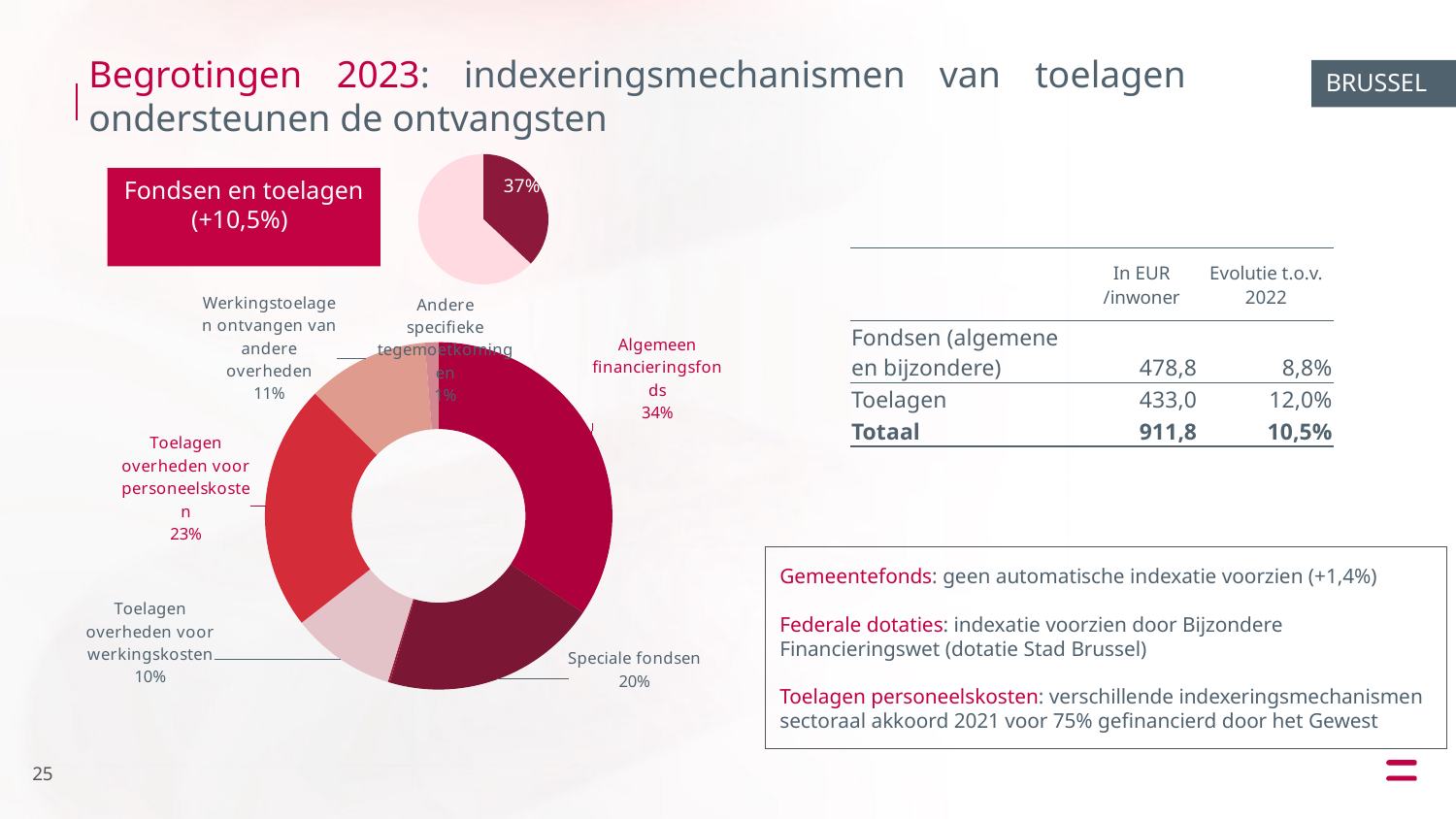
In the doughnut chart on the left, what share does Werkingstoelagen ontvangen van andere overheden have? 11% In the doughnut chart on the left, what is the difference in percentage points between Algemeen financieringsfonds and Speciale fondsen? 14 percentage points In the doughnut chart on the left, what share does Algemeen financieringsfonds have? 34% In the doughnut chart on the left, which is larger: Toelagen overheden voor personeelskosten or Speciale fondsen? Toelagen overheden voor personeelskosten In the small pie chart at the top next to the 'Fondsen en toelagen' box, what percentage is printed on the dark slice? 37% In the doughnut chart on the left, what share does Toelagen overheden voor personeelskosten have? 23% What kind of chart is the large chart on the left of the slide? Doughnut chart In the doughnut chart on the left, what share does Speciale fondsen have? 20% In the doughnut chart on the left, which category has the largest share? Algemeen financieringsfonds In the doughnut chart on the left, what share does Toelagen overheden voor werkingskosten have? 10%